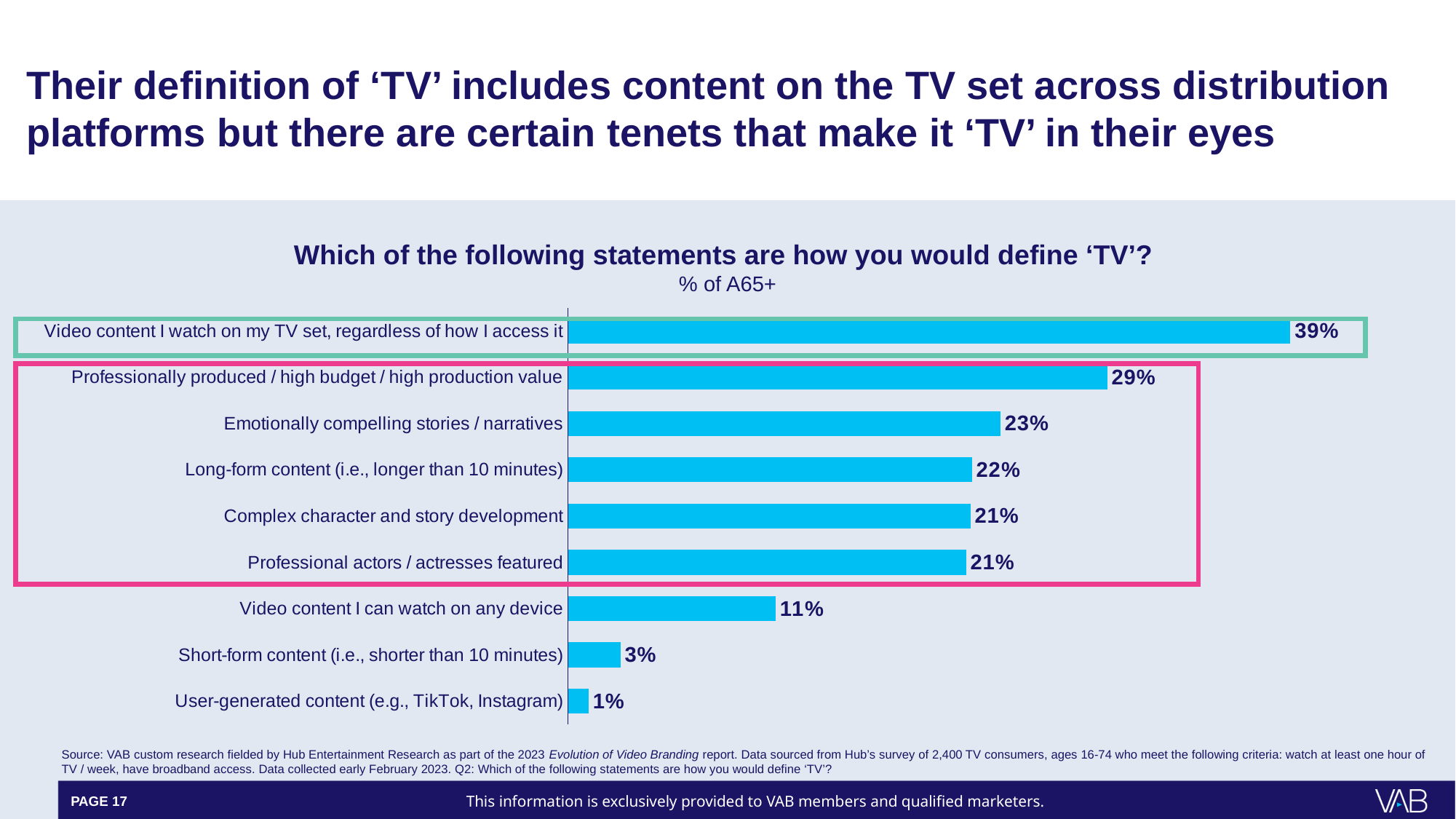
What is the difference between 'Video content I watch on my TV set, regardless of how I access it' and 'Professionally produced / high budget / high production value'? 10% What is the value for 'Emotionally compelling stories / narratives'? 23% What is the difference between 'Professionally produced / high budget / high production value' and 'Video content I can watch on any device'? 18% What is the chart's title? Which of the following statements are how you would define 'TV'? Which statement has the highest percentage? Video content I watch on my TV set, regardless of how I access it How many statements are shown in the chart? 9 What kind of chart is shown on the slide? Bar chart What percentage of A65+ define 'TV' as 'Video content I watch on my TV set, regardless of how I access it'? 39% Which is larger: 'Long-form content (i.e., longer than 10 minutes)' or 'Video content I can watch on any device'? Long-form content (i.e., longer than 10 minutes) Which statement has the lowest percentage? User-generated content (e.g., TikTok, Instagram) What is the value for 'Short-form content (i.e., shorter than 10 minutes)'? 3% What audience group does the chart report percentages for? A65+